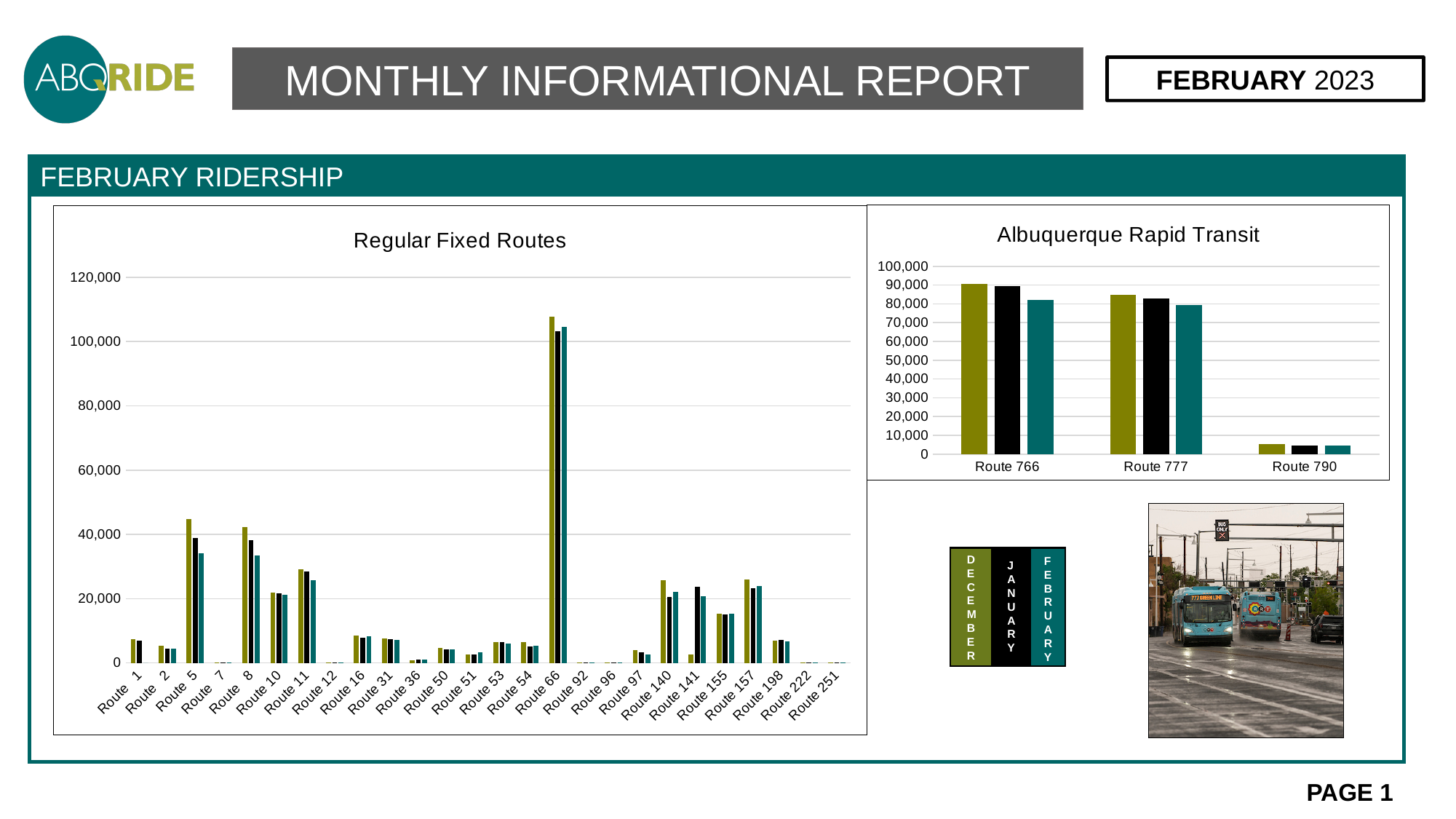
In the Albuquerque Rapid Transit chart, is the December value for Route 790 greater or less than 10,000? less In the Regular Fixed Routes chart, is the February value for Route 66 greater or less than 100,000? greater In the Albuquerque Rapid Transit chart, do the values for Route 766 rise or fall from December to February? fall In the Albuquerque Rapid Transit chart, is the February value for Route 766 greater or less than 90,000? less How many months (series) does the legend on the slide list for the charts? 3 What kind of chart is the Regular Fixed Routes chart? bar chart How many routes are shown on the x axis of the Regular Fixed Routes chart? 26 In the Albuquerque Rapid Transit chart, which route has the lowest ridership? Route 790 In the Regular Fixed Routes chart, which has the larger December value, Route 5 or Route 11? Route 5 How many routes are shown in the Albuquerque Rapid Transit chart? 3 In the Regular Fixed Routes chart, which route has the highest ridership? Route 66